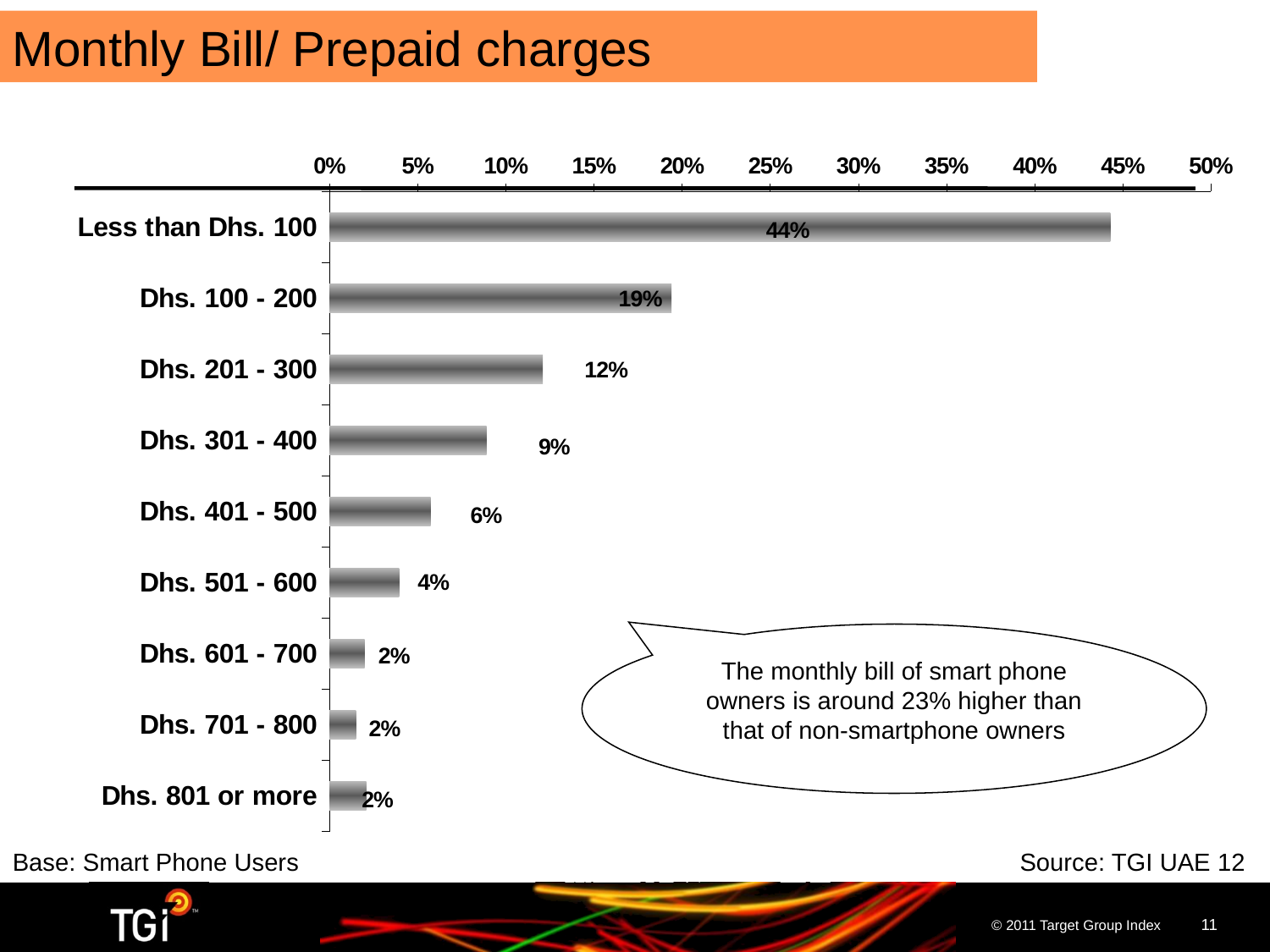
Which category has the highest value? Less than Dhs. 100 Do the values rise or fall going from Less than Dhs. 100 down to Dhs. 801 or more? fall What is the value for Dhs. 201 - 300? 12% What is the title of the slide? Monthly Bill/ Prepaid charges What is the difference between the values for Less than Dhs. 100 and Dhs. 100 - 200? 25% Is the value for Less than Dhs. 100 greater or less than 40%? greater What is the value for Less than Dhs. 100? 44% What is the difference between the values for Dhs. 301 - 400 and Dhs. 501 - 600? 5% What kind of chart is shown on the slide? bar chart How many categories are shown in the chart? 9 What is the value for Dhs. 401 - 500? 6% Which is larger, the value for Dhs. 100 - 200 or the value for Dhs. 201 - 300? Dhs. 100 - 200